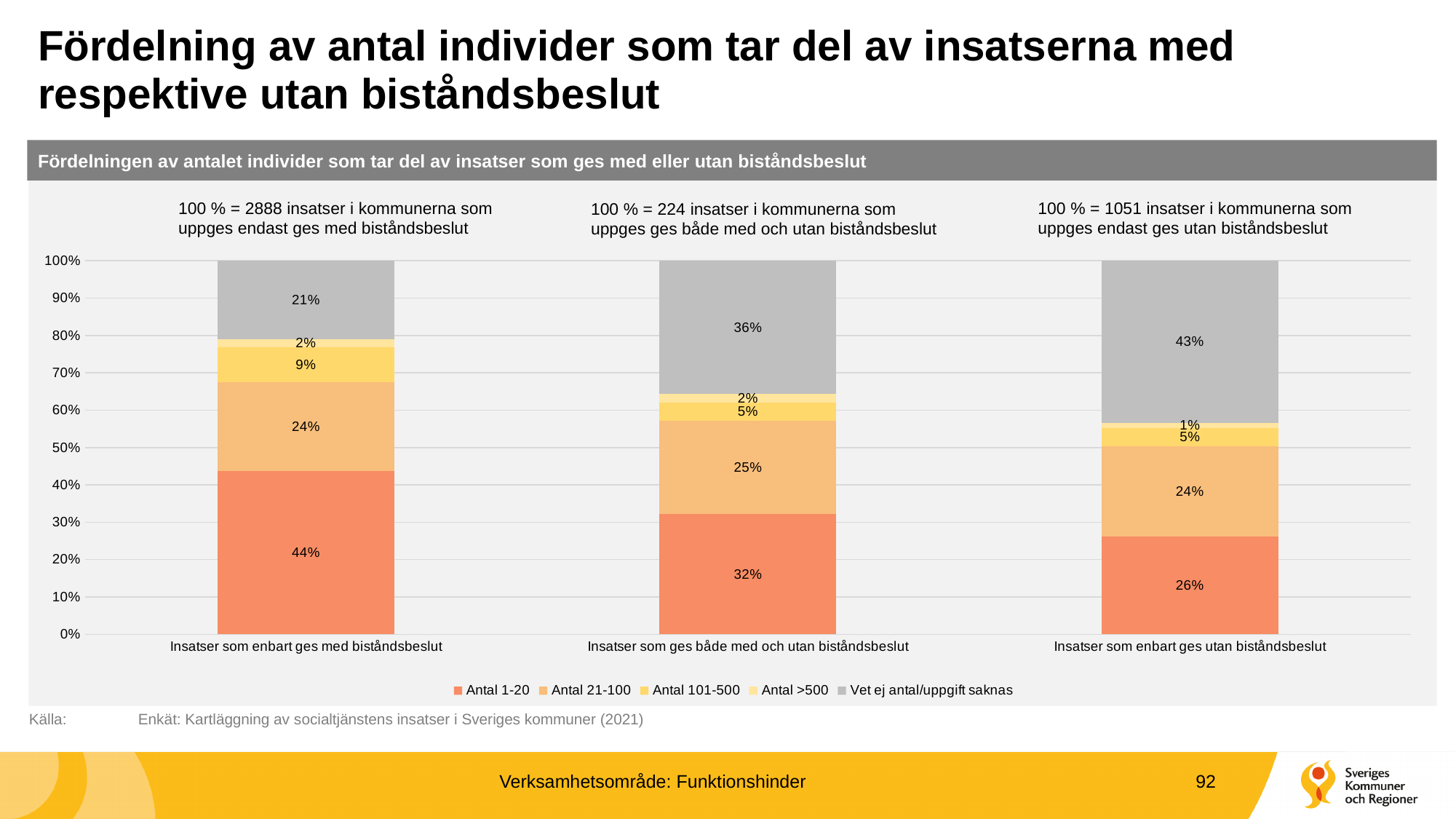
What is the value of 'Antal >500' for 'Insatser som enbart ges utan biståndsbeslut'? 1% How many series does the legend list? 5 Which is larger: 'Antal 101-500' for 'Insatser som enbart ges med biståndsbeslut' or for 'Insatser som ges både med och utan biståndsbeslut'? Insatser som enbart ges med biståndsbeslut What is the difference between the 'Antal 1-20' values for 'Insatser som enbart ges med biståndsbeslut' and 'Insatser som enbart ges utan biståndsbeslut'? 18% What is the value of 'Antal 21-100' for 'Insatser som ges både med och utan biståndsbeslut'? 25% What kind of chart is shown on the slide? Stacked bar chart What is the value of 'Antal 1-20' for 'Insatser som enbart ges med biståndsbeslut'? 44% According to the text above the chart, how many insatser does 100 % correspond to for 'Insatser som ges både med och utan biståndsbeslut'? 224 Which category has the highest value for 'Antal 1-20'? Insatser som enbart ges med biståndsbeslut What is the value of 'Vet ej antal/uppgift saknas' for 'Insatser som enbart ges utan biståndsbeslut'? 43% How many categories (bars) are shown on the x axis? 3 Which category has the lowest value for 'Vet ej antal/uppgift saknas'? Insatser som enbart ges med biståndsbeslut